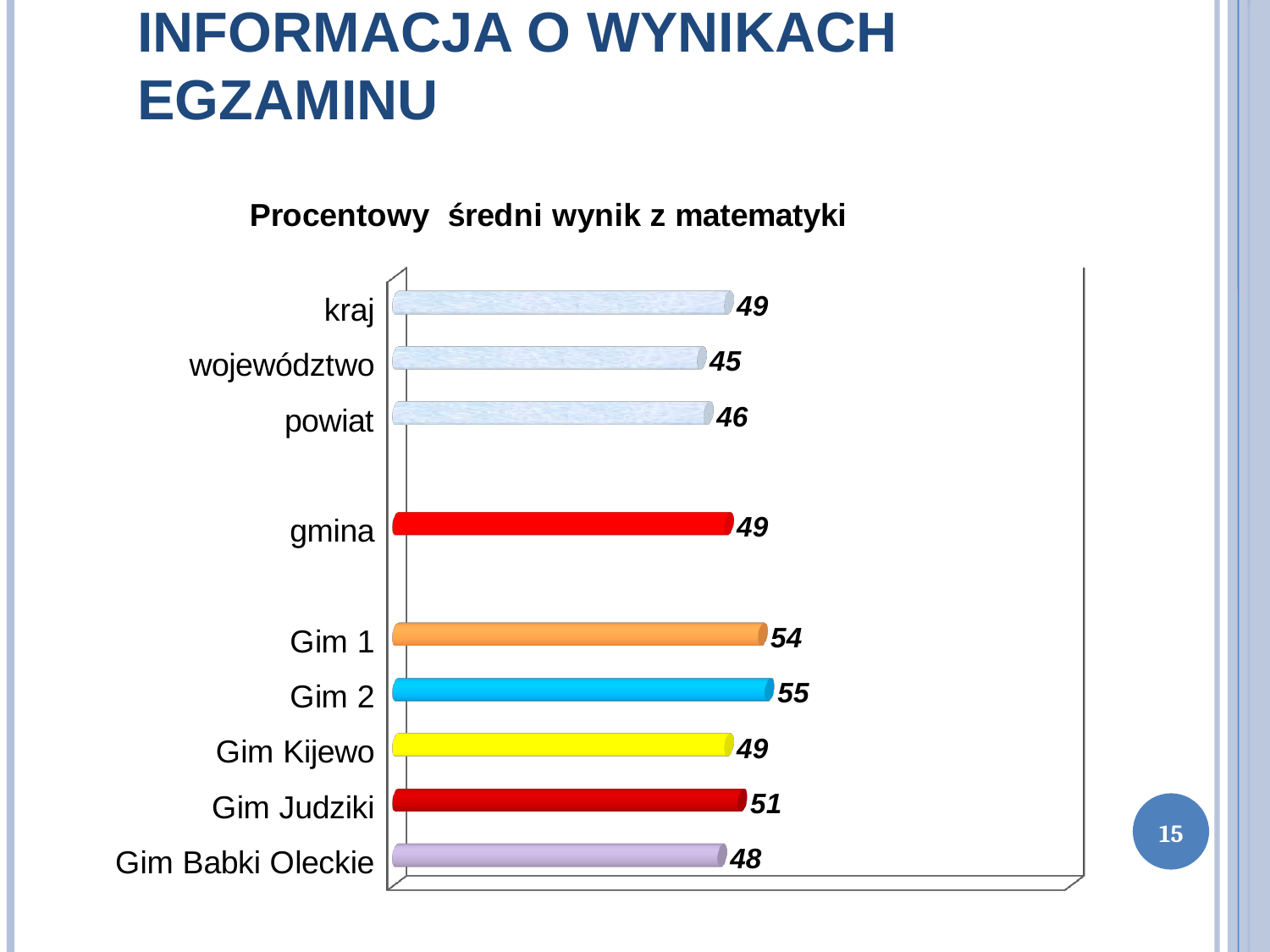
What kind of chart is shown on the slide? bar chart Which category has the lowest value? województwo What is the title of the chart? Procentowy średni wynik z matematyki What is the value for powiat? 46 What is the value for Gim Babki Oleckie? 48 Which category has the highest value? Gim 2 What is the value for województwo? 45 What is the difference between the values for Gim 1 and Gim Babki Oleckie? 6 Which is larger, the value for Gim Judziki or the value for Gim Kijewo? Gim Judziki What is the difference between the values for Gim 2 and województwo? 10 How many categories are shown in the chart? 9 What is the value for Gim 2? 55